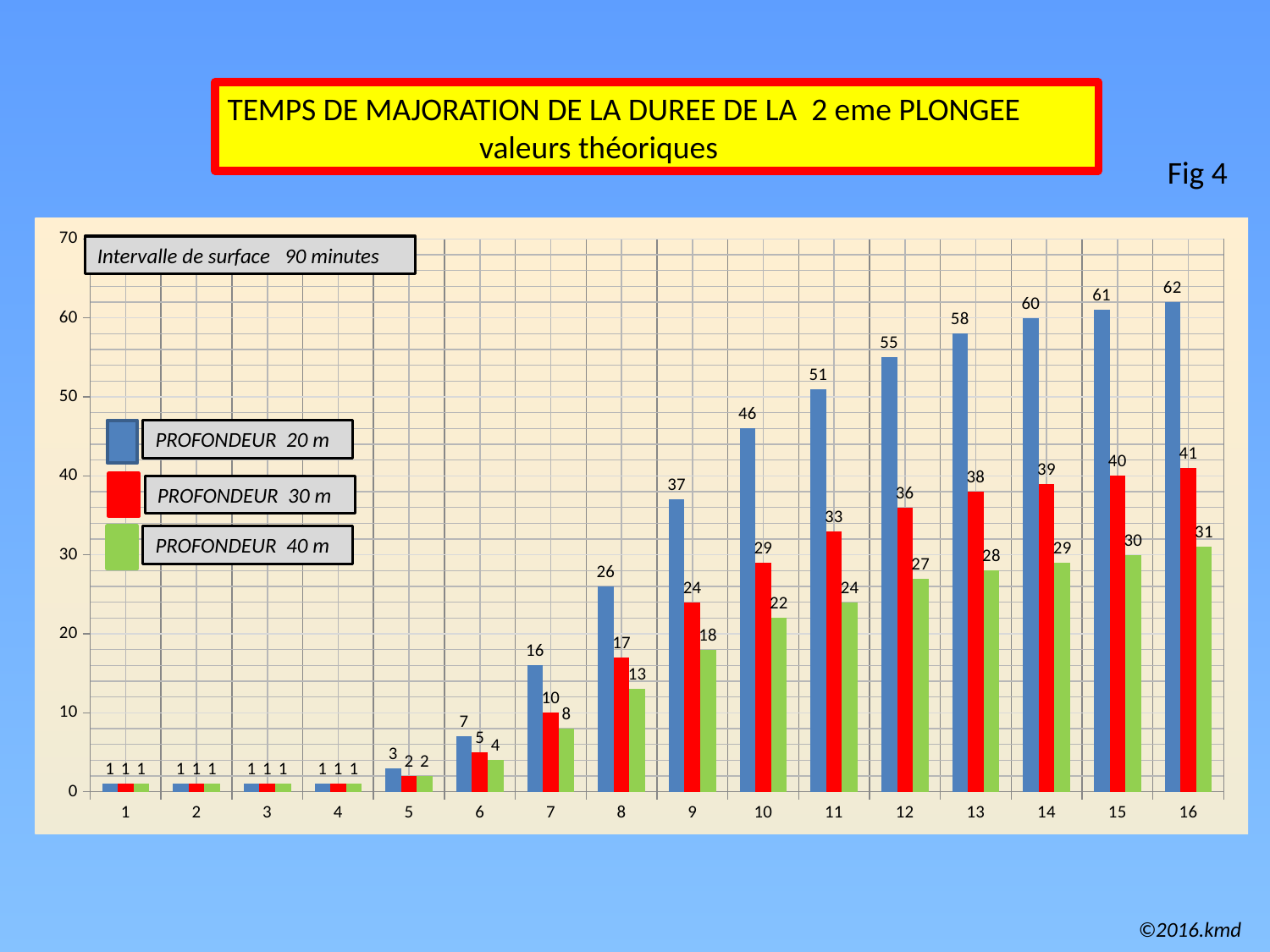
What colour represents the PROFONDEUR 30 m series? red What is the value for PROFONDEUR 30 m at category 13? 38 Do the PROFONDEUR 20 m values rise or fall from category 5 to category 16? rise How many categories are shown along the x axis? 16 Which category has the highest value for PROFONDEUR 20 m? 16 What is the value for PROFONDEUR 20 m at category 10? 46 What surface interval is stated in the box inside the chart? 90 minutes How many series does the legend list? 3 What is the value for PROFONDEUR 40 m at category 8? 13 What type of chart is shown on the slide? bar chart Which is larger at category 9: the PROFONDEUR 30 m value or the PROFONDEUR 40 m value? PROFONDEUR 30 m What is the difference between the PROFONDEUR 20 m and PROFONDEUR 40 m values at category 16? 31